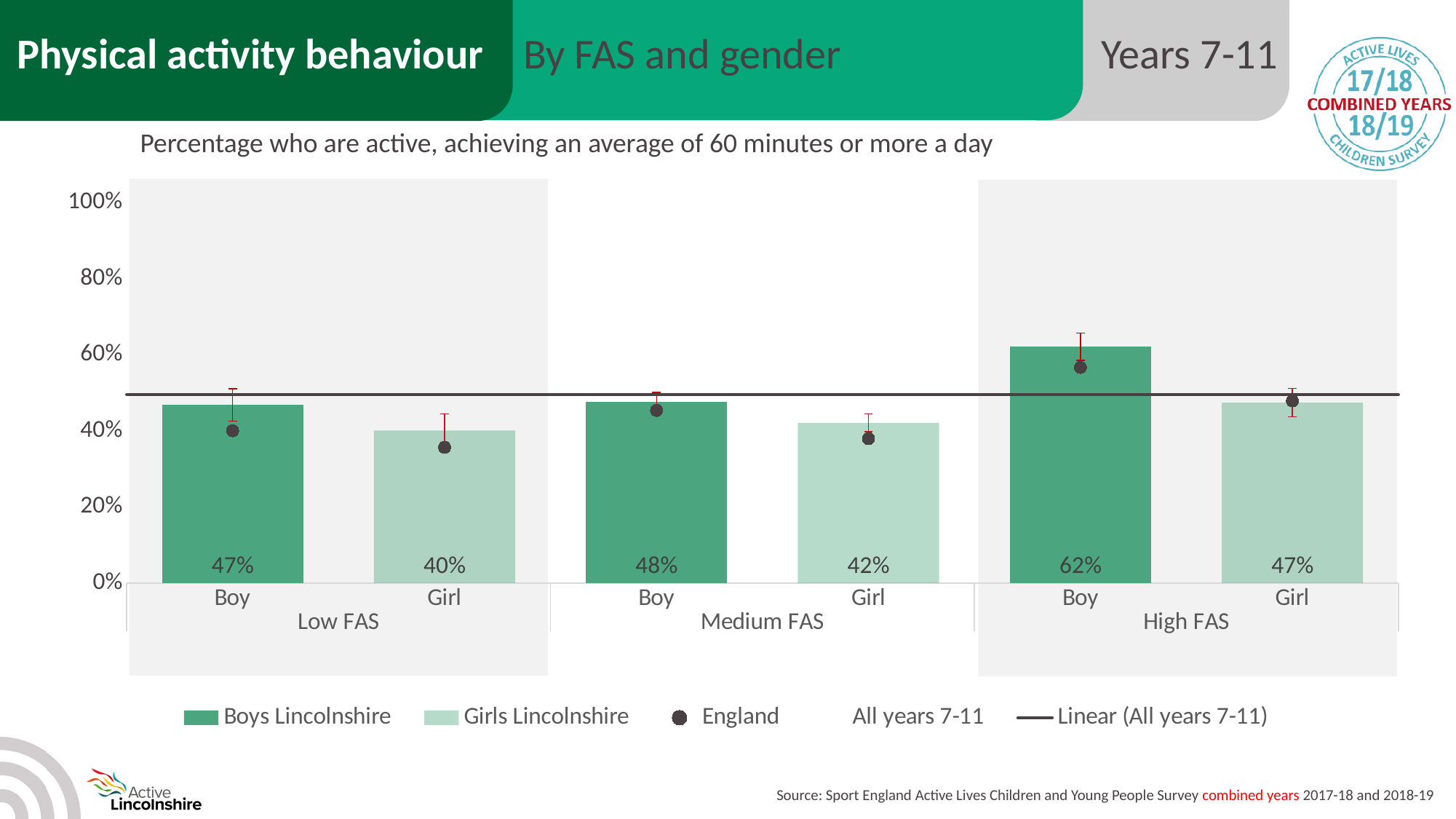
Which bar has the highest value on the chart? High FAS Boy What is the difference between the High FAS boys value and the High FAS girls value? 15% What kind of chart is shown on the slide? Bar chart How many entries does the legend list? 5 Is the value for High FAS boys greater or less than 60%? greater Which bar has the lowest value on the chart? Low FAS Girl Which is larger, the Low FAS girls value or the Medium FAS girls value? Medium FAS girls What is the percentage of active boys in the High FAS group in Lincolnshire? 62% How many bars are plotted on the chart? 6 What is the difference between the Medium FAS boys value and the Low FAS boys value? 1% What is the percentage of active girls in the Medium FAS group in Lincolnshire? 42% What is the percentage of active boys in the Low FAS group in Lincolnshire? 47%